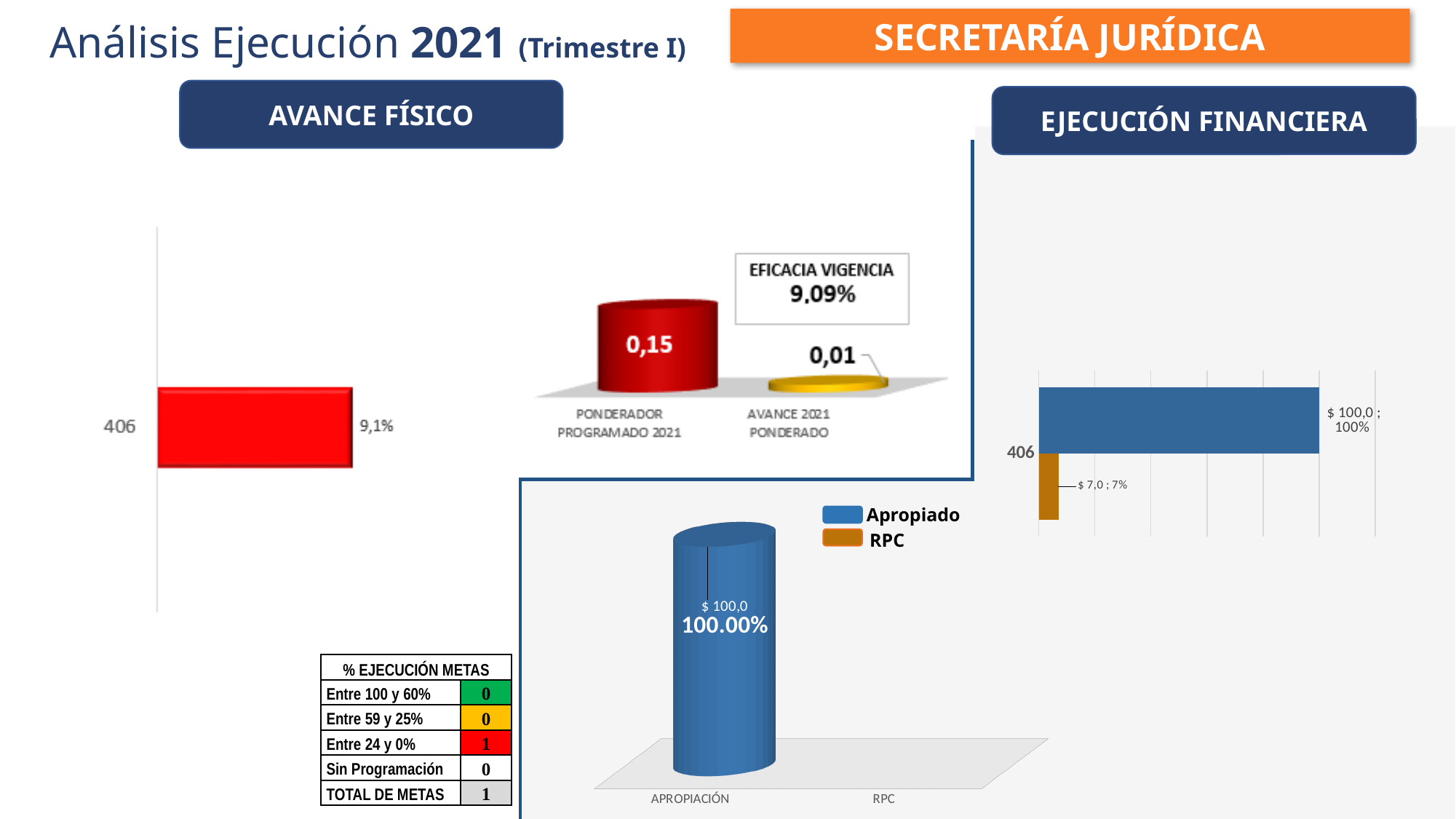
What kind of chart is the red chart under AVANCE FÍSICO? Bar chart In the cylinder chart next to EFICACIA VIGENCIA, what is the difference between PONDERADOR PROGRAMADO 2021 and AVANCE 2021 PONDERADO? 0,14 In the horizontal bar chart under EJECUCIÓN FINANCIERA, which series has the larger bar, Apropiado or RPC? Apropiado In the blue cylinder chart at the bottom of the slide, what percentage is labelled on the APROPIACIÓN cylinder? 100.00% In the cylinder chart next to EFICACIA VIGENCIA, what is the value for PONDERADOR PROGRAMADO 2021? 0,15 In the cylinder chart next to EFICACIA VIGENCIA, what is the value for AVANCE 2021 PONDERADO? 0,01 In the horizontal bar chart under EJECUCIÓN FINANCIERA, what is the label on the RPC bar for 406? $ 7,0 ; 7% In the cylinder chart next to EFICACIA VIGENCIA, which category has the higher value? PONDERADOR PROGRAMADO 2021 In the red horizontal bar chart under AVANCE FÍSICO, what value is labelled on the bar for category 406? 9,1% How many series does the legend of the EJECUCIÓN FINANCIERA bar chart list? 2 What EFICACIA VIGENCIA percentage is shown in the box above the cylinder chart? 9.09% In the horizontal bar chart under EJECUCIÓN FINANCIERA, what is the label on the Apropiado bar for 406? $ 100,0 ; 100%